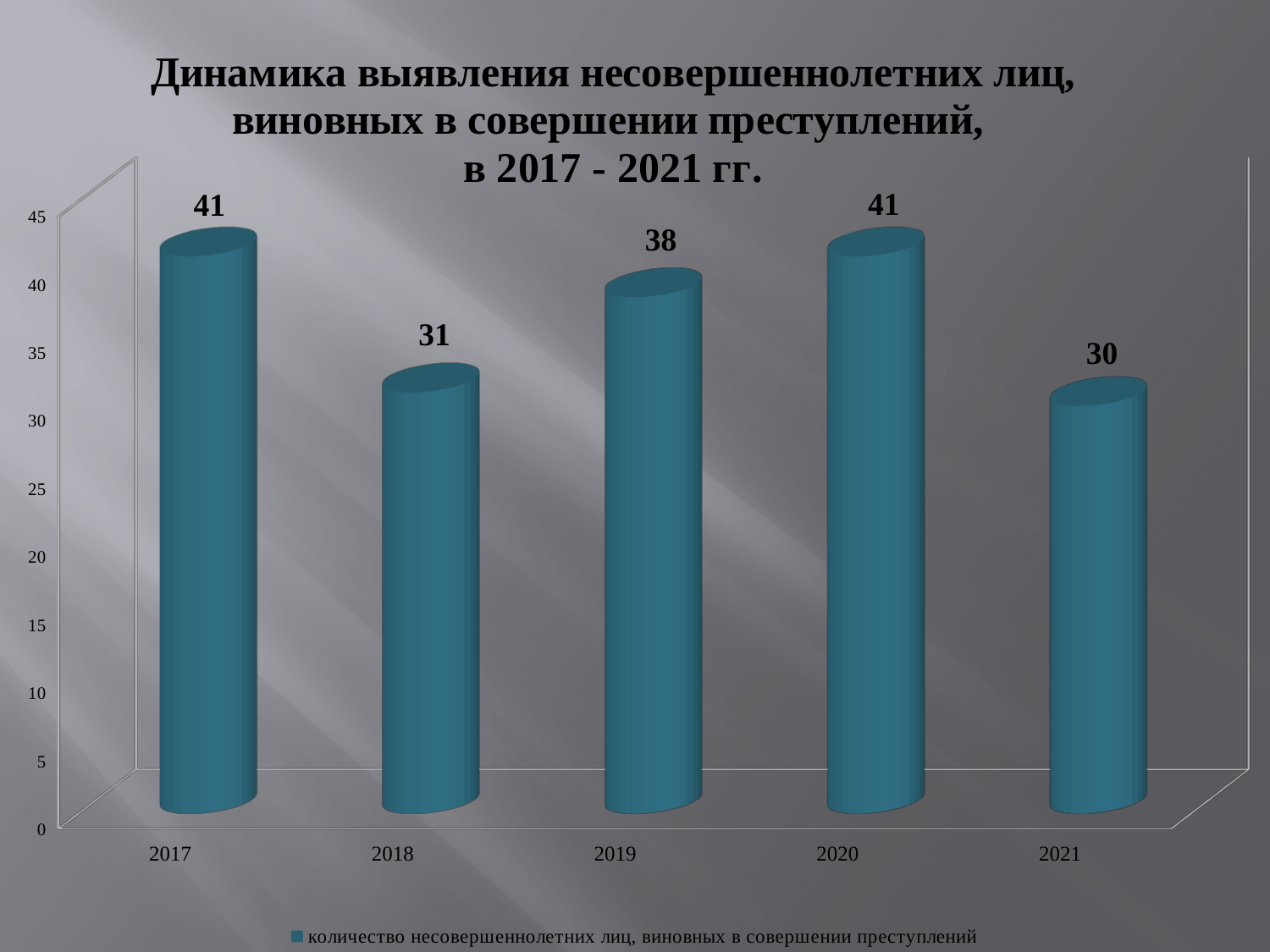
What is the value for 2018? 31 What is the value for 2019? 38 What is the difference between the values for 2019 and 2018? 7 What is the difference between the values for 2020 and 2021? 11 What kind of chart is shown on the slide? bar chart Which is larger, the value for 2019 or the value for 2021? 2019 How many series does the legend list? 1 How many years are shown on the x axis? 5 Does the value rise or fall from 2020 to 2021? fall What is the value for 2021? 30 Which year has the lowest value? 2021 What is the value for 2017? 41